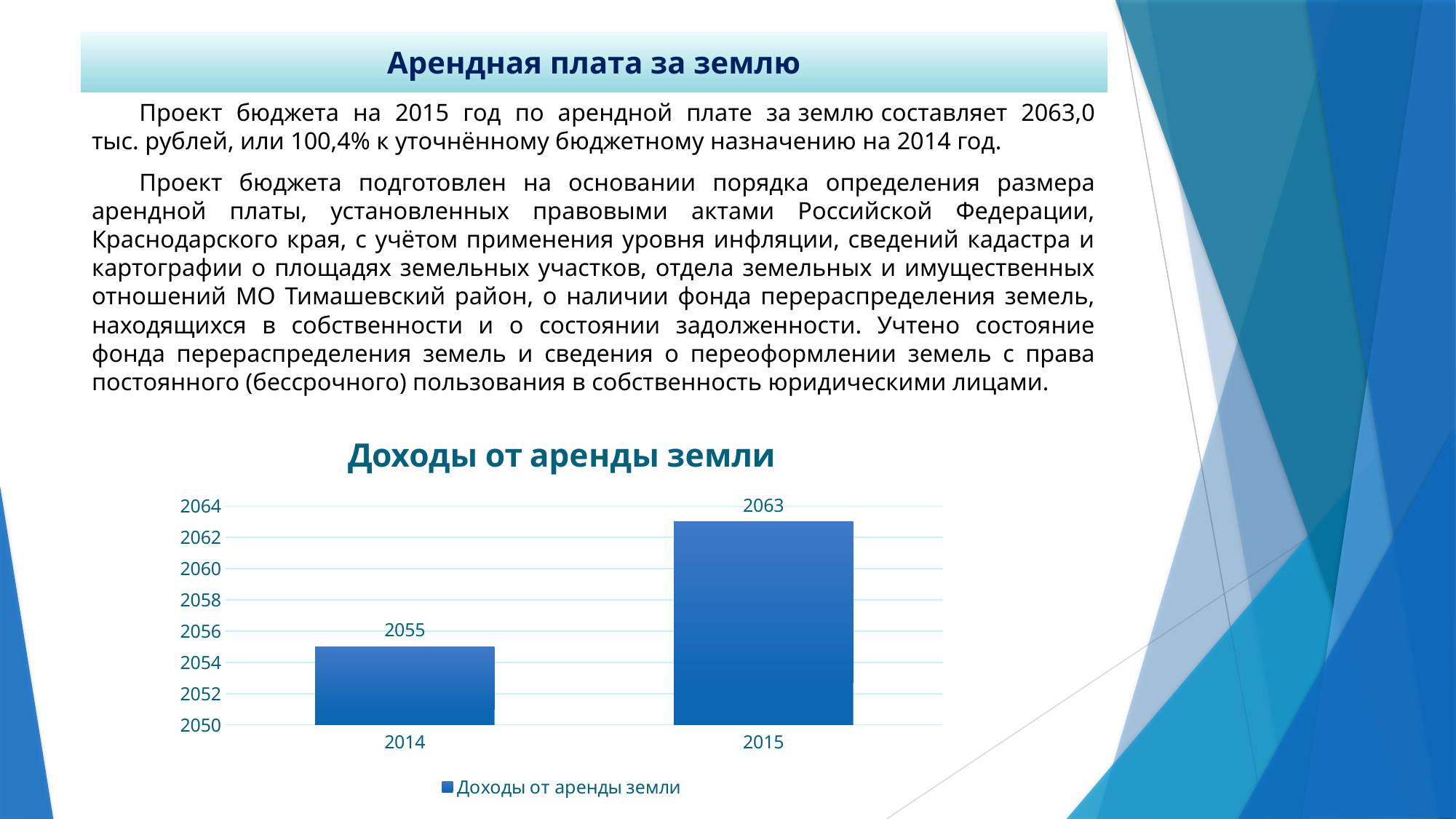
What is the value for 2014 in the chart? 2055 What kind of chart is shown on the slide? bar chart How many series does the chart legend list? 1 How many categories are shown on the x axis of the chart? 2 What is the value for 2015 in the chart? 2063 Which year has the lowest value in the chart? 2014 Is the value for 2014 greater or less than 2060? less What is the difference between the values for 2015 and 2014? 8 Is the value for 2015 greater or less than 2060? greater What is the title of the chart? Доходы от аренды земли Which is larger, the value for 2014 or the value for 2015? 2015 Which year has the highest value in the chart? 2015